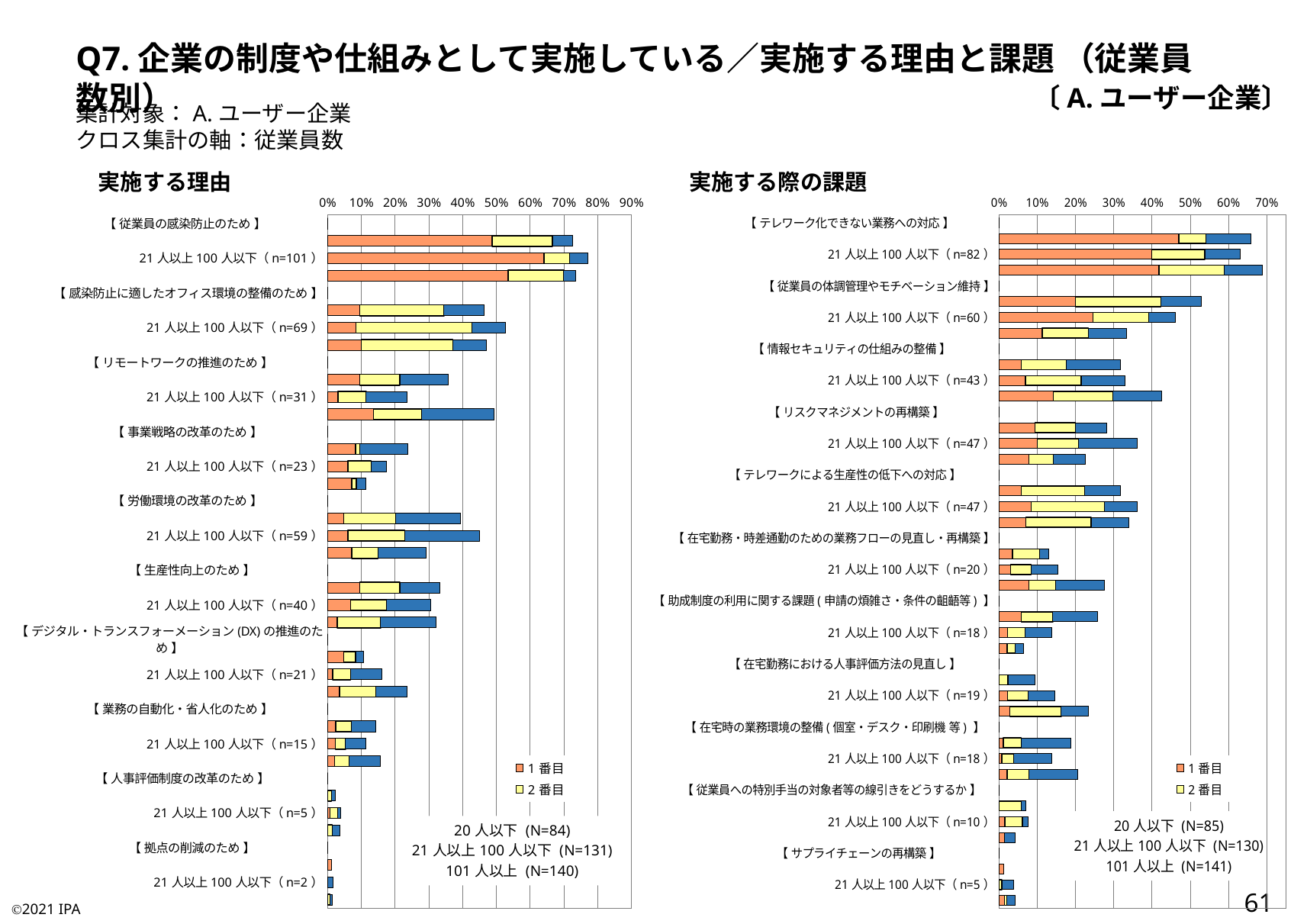
In the 実施する理由 chart on the left, is the total bar for 21 人以上 100 人以下 (n=101) under 従業員の感染防止のため greater or less than 70%? greater In the 実施する理由 chart on the left, which reason category has the longest bars? 従業員の感染防止のため What kind of chart is the 実施する理由 chart on the left? Bar chart How many series does the legend of the 実施する際の課題 chart on the right list? 2 In the 実施する理由 chart on the left, which reason category has the shortest bars? 拠点の削減のため In the 実施する際の課題 chart on the right, which total bar is longer: 21 人以上 100 人以下 (n=60) under 従業員の体調管理やモチベーション維持 or 21 人以上 100 人以下 (n=43) under 情報セキュリティの仕組みの整備? 21 人以上 100 人以下 (n=60) under 従業員の体調管理やモチベーション維持 In the 実施する理由 chart on the left, what are the two legend entries? 1 番目, 2 番目 In the 実施する理由 chart on the left, what is the highest percentage shown on the x axis? 90% In the 実施する理由 chart on the left, how many reason categories (bracketed headings) are shown? 10 In the 実施する理由 chart on the left, is the total bar for 21 人以上 100 人以下 (n=5) under 人事評価制度の改革のため greater or less than 10%? less In the 実施する際の課題 chart on the right, which issue category has the shortest bars? サプライチェーンの再構築 In the 実施する際の課題 chart on the right, which issue category has the longest bars? テレワーク化できない業務への対応